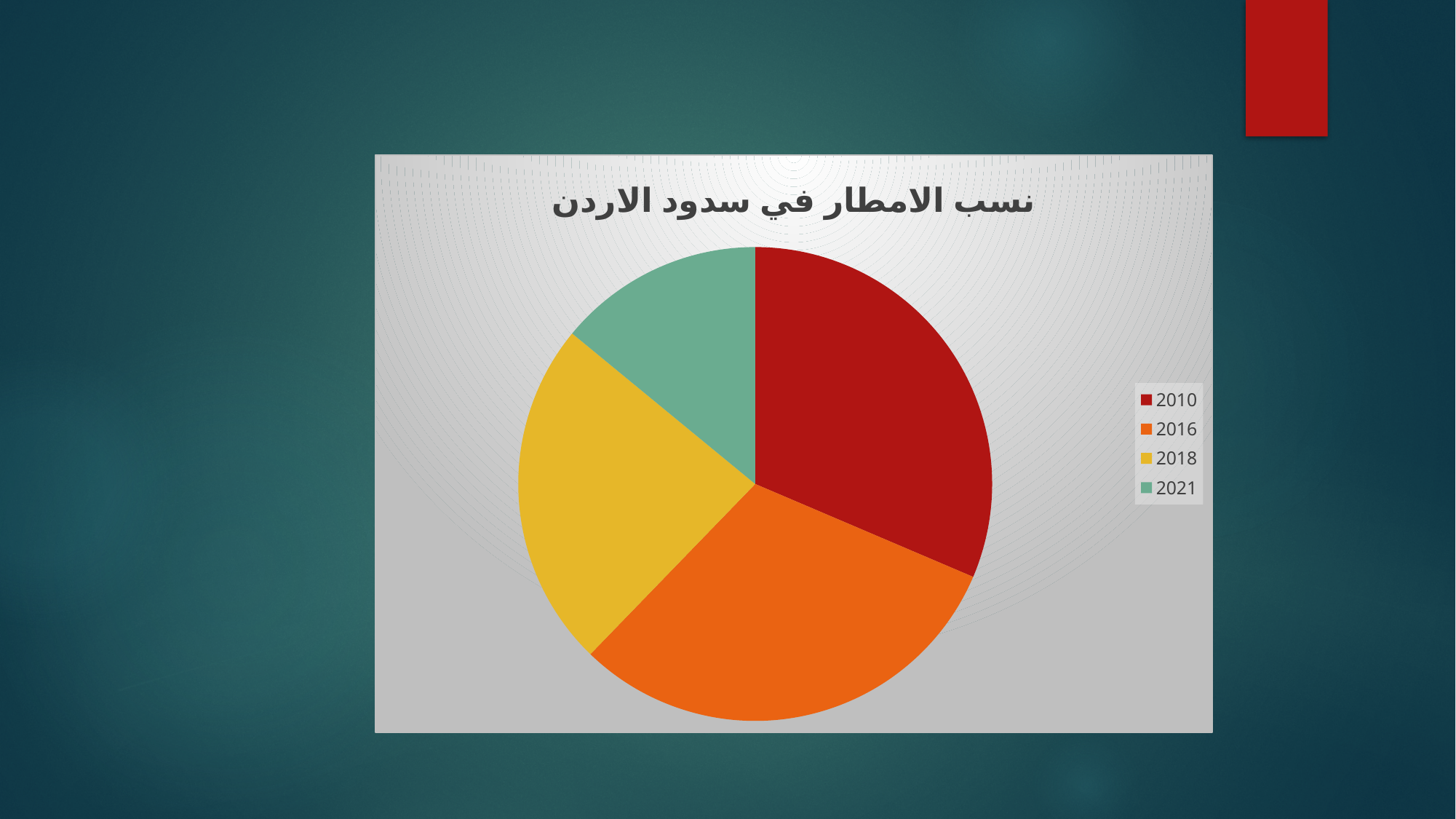
What is the title of the pie chart? نسب الامطار في سدود الاردن Which year is represented by the green slice in the pie chart? 2021 How many slices does the pie chart have? 4 Which slice is larger in the pie chart, 2016 or 2021? 2016 What kind of chart is shown on the slide? pie chart Which year has the smallest slice in the pie chart? 2021 Which slice is larger in the pie chart, 2010 or 2018? 2010 Which slice is larger in the pie chart, 2010 or 2021? 2010 How many entries does the legend of the pie chart list? 4